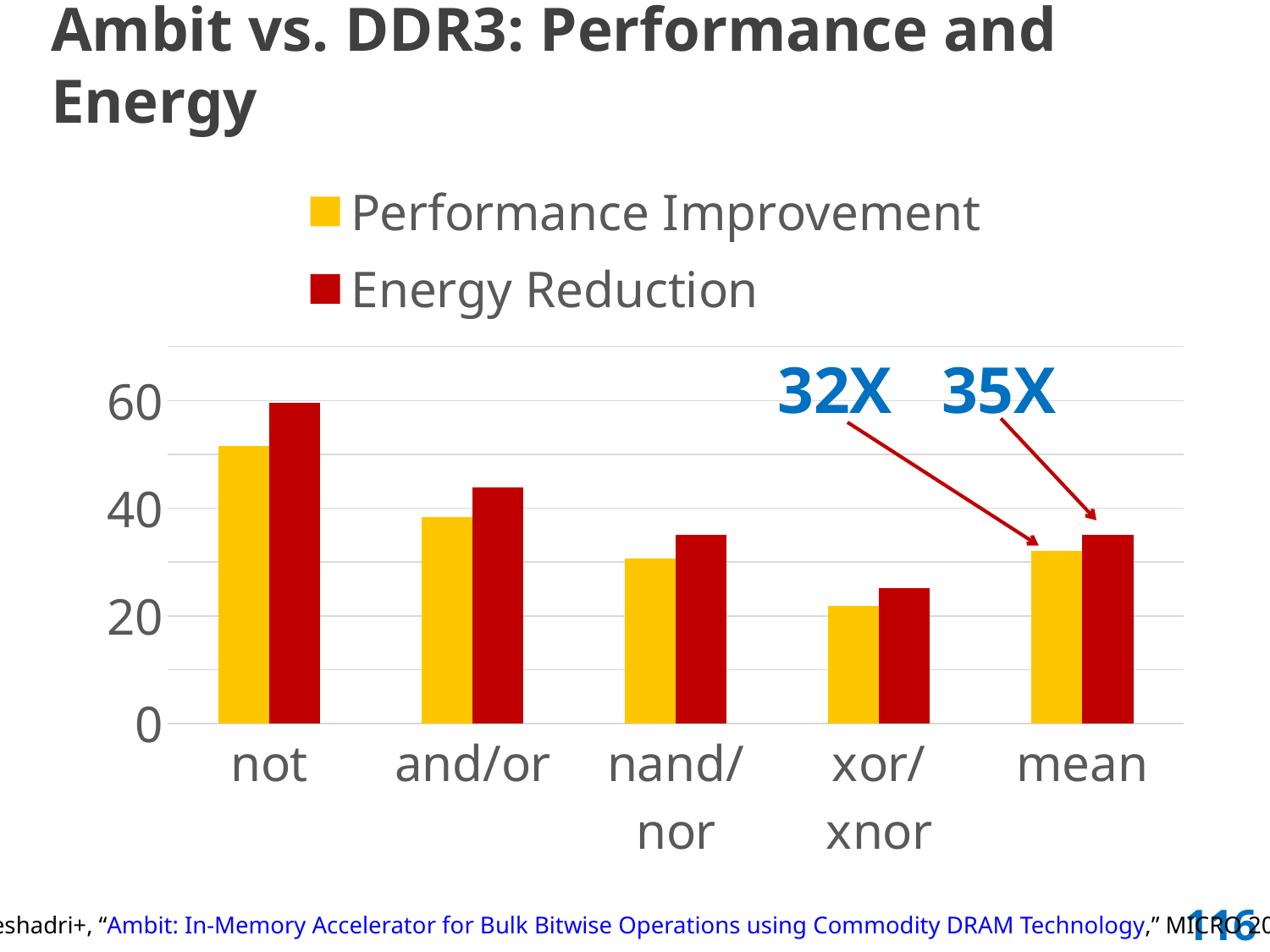
What is the Performance Improvement value for the mean category? 32X Do the Energy Reduction values rise or fall from not to xor/xnor? fall What is the Energy Reduction value for the mean category? 35X For the not category, which is larger: Performance Improvement or Energy Reduction? Energy Reduction Which category has the highest Performance Improvement? not Is the Performance Improvement value for nand/nor greater or less than 20? greater Which category has the lowest Energy Reduction? xor/xnor Is the Energy Reduction value for not greater or less than 40? greater What kind of chart is shown on the slide? bar chart How many series does the legend list? 2 Is the Performance Improvement value for xor/xnor greater or less than 40? less How many categories are shown on the x axis? 5